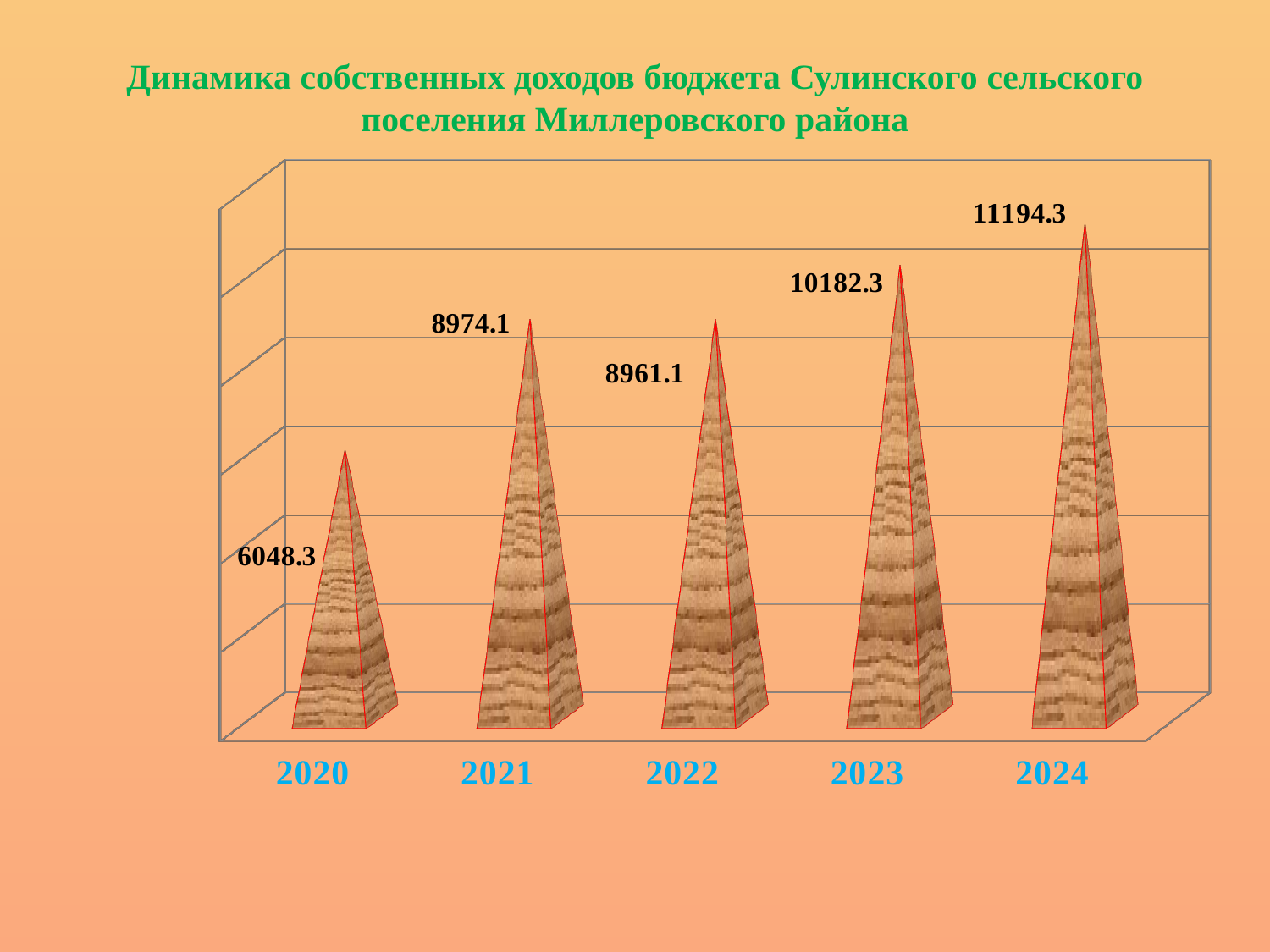
Which is larger, the value for 2023 or the value for 2022? 2023 What is the value for 2023? 10182.3 What is the value for 2022? 8961.1 Which year has the highest value? 2024 What is the value for 2024? 11194.3 What is the difference between the values for 2024 and 2023? 1012.0 What is the value for 2020? 6048.3 What kind of chart is this? bar chart Do the values generally rise or fall from 2020 to 2024? rise What is the difference between the values for 2021 and 2020? 2925.8 How many years are shown on the chart? 5 Which year has the lowest value? 2020